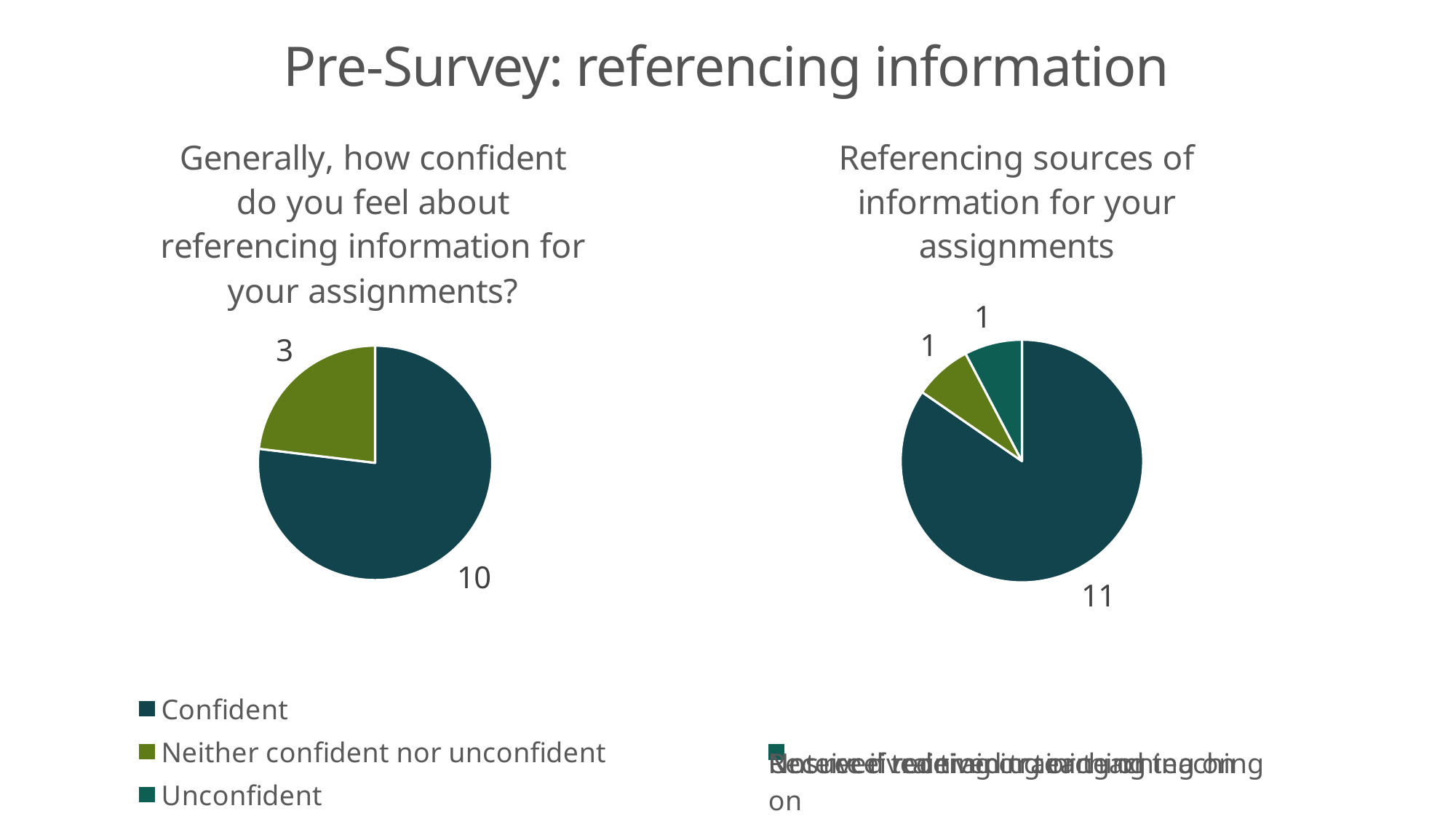
On the right chart titled 'Referencing sources of information for your assignments', what is the total of all slice values? 13 On the left chart, how many respondents answered 'Confident'? 10 On the left chart, which is larger: 'Confident' or 'Neither confident nor unconfident'? Confident How many entries does the legend of the left chart list? 3 What is the title of the slide? Pre-Survey: referencing information On the left chart, how many respondents answered 'Neither confident nor unconfident'? 3 What type of chart is the left chart? Pie chart On the left chart, what is the difference between the 'Confident' and 'Neither confident nor unconfident' counts? 7 On the right chart titled 'Referencing sources of information for your assignments', what is the difference between the largest slice and one of the smallest slices? 10 On the left chart, which category has the largest slice? Confident On the right chart titled 'Referencing sources of information for your assignments', what is the value of the largest slice? 11 On the right chart titled 'Referencing sources of information for your assignments', how many slices are shown? 3